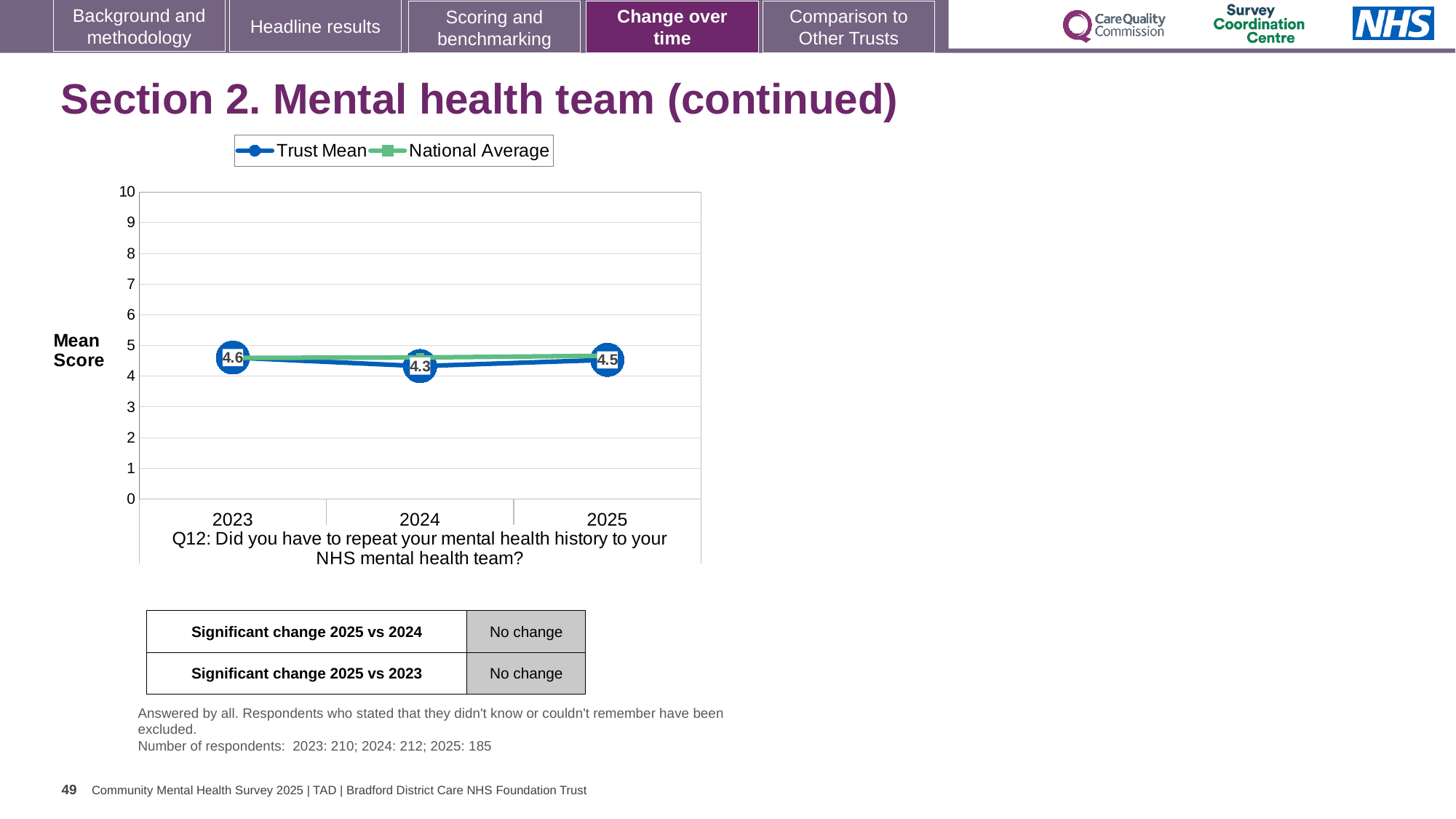
In which year is the Trust Mean score highest? 2023 Which survey question does the chart relate to? Q12: Did you have to repeat your mental health history to your NHS mental health team? What is the Trust Mean score for 2025? 4.5 What kind of chart is shown on the slide? line chart In which year is the Trust Mean score lowest? 2024 Which is larger, the Trust Mean score for 2025 or for 2024? 2025 What is the Trust Mean score for 2024? 4.3 How many years are plotted on the x axis of the chart? 3 What is the difference between the Trust Mean scores for 2023 and 2024? 0.3 What is the Trust Mean score for 2023? 4.6 How many series does the chart legend list? 2 Is the Trust Mean score for 2025 greater or less than 5? less